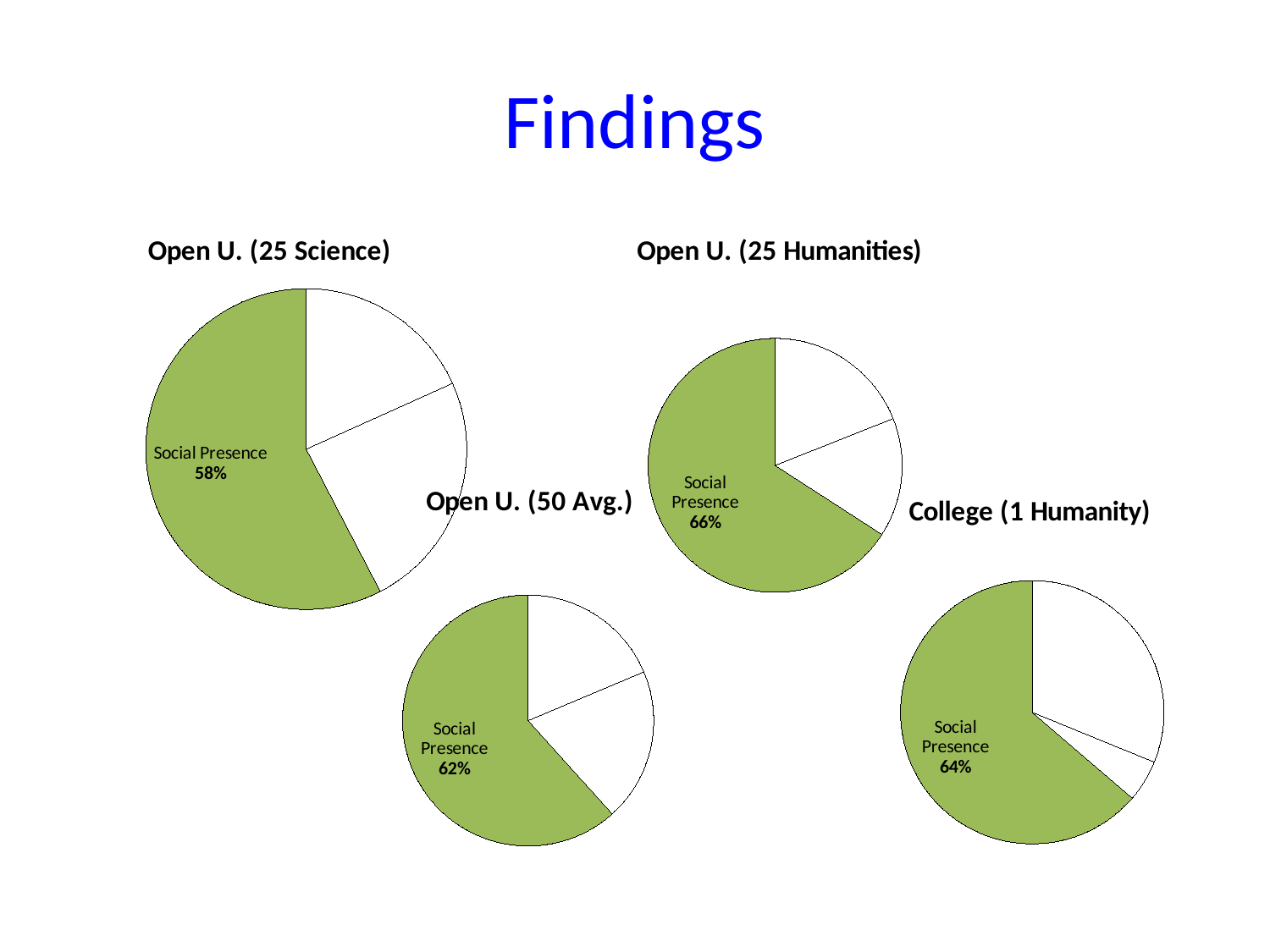
How many pie charts are shown on the slide? 4 In the Open U. (25 Science) chart, what share of the pie is Social Presence? 58% What kind of chart is the Open U. (25 Science) chart? Pie chart Which chart shows the highest Social Presence percentage? Open U. (25 Humanities) Is the Social Presence share larger in the Open U. (25 Humanities) chart or the College (1 Humanity) chart? Open U. (25 Humanities) In the Open U. (50 Avg.) chart, what is the value shown for Social Presence? 62% Which chart shows the lowest Social Presence percentage? Open U. (25 Science) What colour is the Social Presence slice in the pie charts? Green How many slices does the Open U. (50 Avg.) pie chart have? 3 What is the difference in Social Presence percentage between the Open U. (25 Humanities) chart and the Open U. (25 Science) chart? 8 percentage points In the College (1 Humanity) chart, what share of the pie is Social Presence? 64% In the Open U. (25 Humanities) chart, what percentage is labelled for Social Presence? 66%